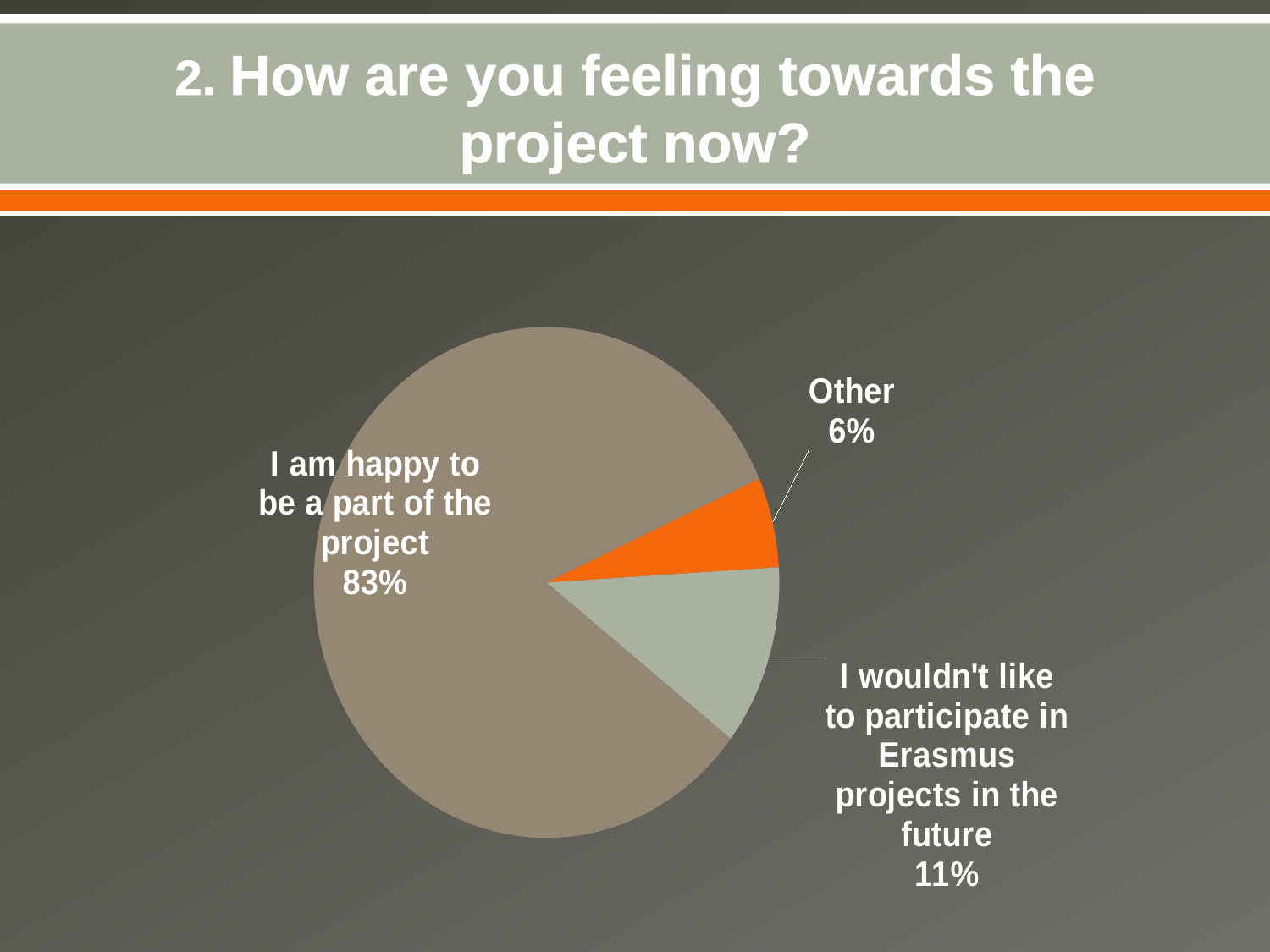
What share of the pie is labelled "Other"? 6% Which category has the largest slice of the pie? I am happy to be a part of the project What share of respondents said "I wouldn't like to participate in Erasmus projects in the future"? 11% What is the difference in percentage points between "I wouldn't like to participate in Erasmus projects in the future" and "Other"? 5 Which category has the smallest slice of the pie? Other What share of respondents said "I am happy to be a part of the project"? 83% What is the title of the slide containing the pie chart? 2. How are you feeling towards the project now? Which is larger: the share for "Other" or the share for "I wouldn't like to participate in Erasmus projects in the future"? I wouldn't like to participate in Erasmus projects in the future What colour is the "Other" slice of the pie? orange How many slices does the pie chart have? 3 What is the difference in percentage points between "I am happy to be a part of the project" and "I wouldn't like to participate in Erasmus projects in the future"? 72 What kind of chart is shown on the slide? pie chart